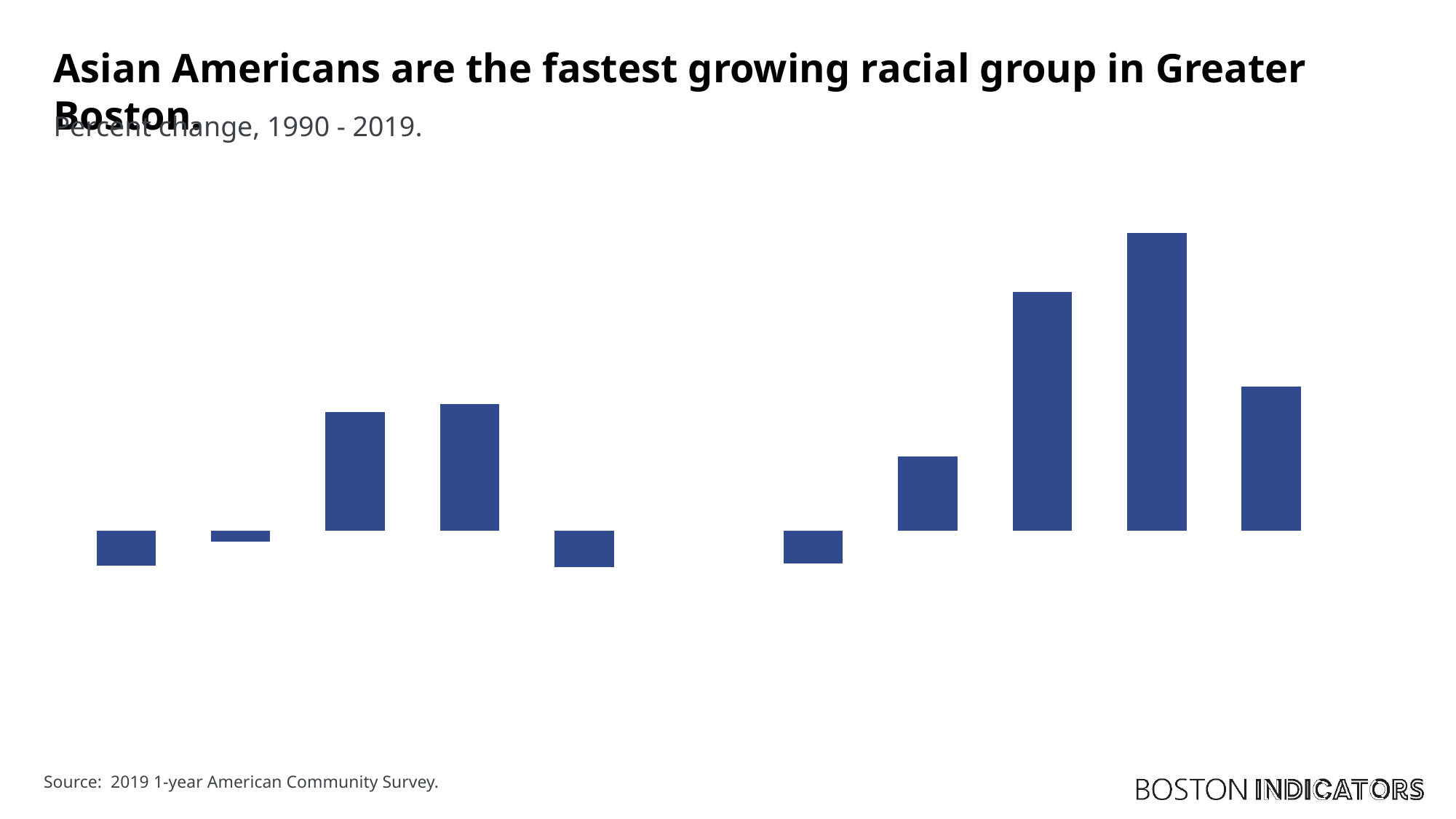
Is the rightmost bar above or below the baseline? above Which bar is the tallest: the second from the right or the third from the right? second from the right Which bar is the tallest in the chart, counting from the left? the ninth bar Is the leftmost bar above or below the baseline? below How many bars extend below the baseline (negative values)? 4 What is the title of the chart on the slide? Asian Americans are the fastest growing racial group in Greater Boston. What does the subtitle say the chart measures? Percent change, 1990 - 2019. How many bars are visible in the chart? 10 What kind of chart is shown on the slide? bar chart